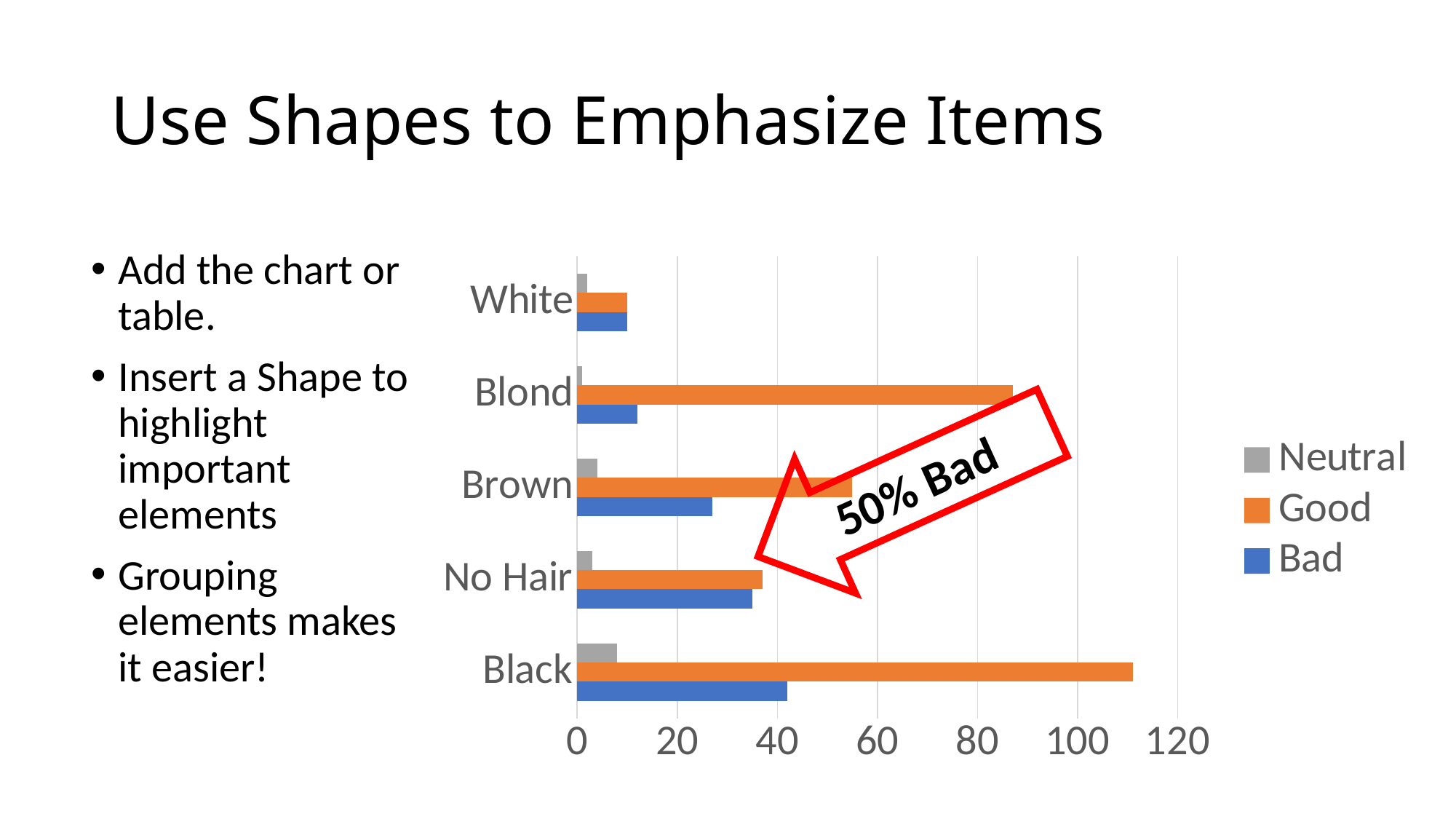
Which category has the highest Bad value? Black Is the Good value for No Hair greater or less than 60? less Which is larger, the Good value for Brown or the Good value for No Hair? Brown Is the Good value for Black greater or less than 100? greater What text is written inside the red arrow shape on the chart? 50% Bad What kind of chart is shown on the slide? bar chart Which category has the highest Good value? Black Which category has the lowest Good value? White Is the Bad value for Brown greater or less than 20? greater How many hair colour categories are shown on the chart? 5 How many series does the chart legend list? 3